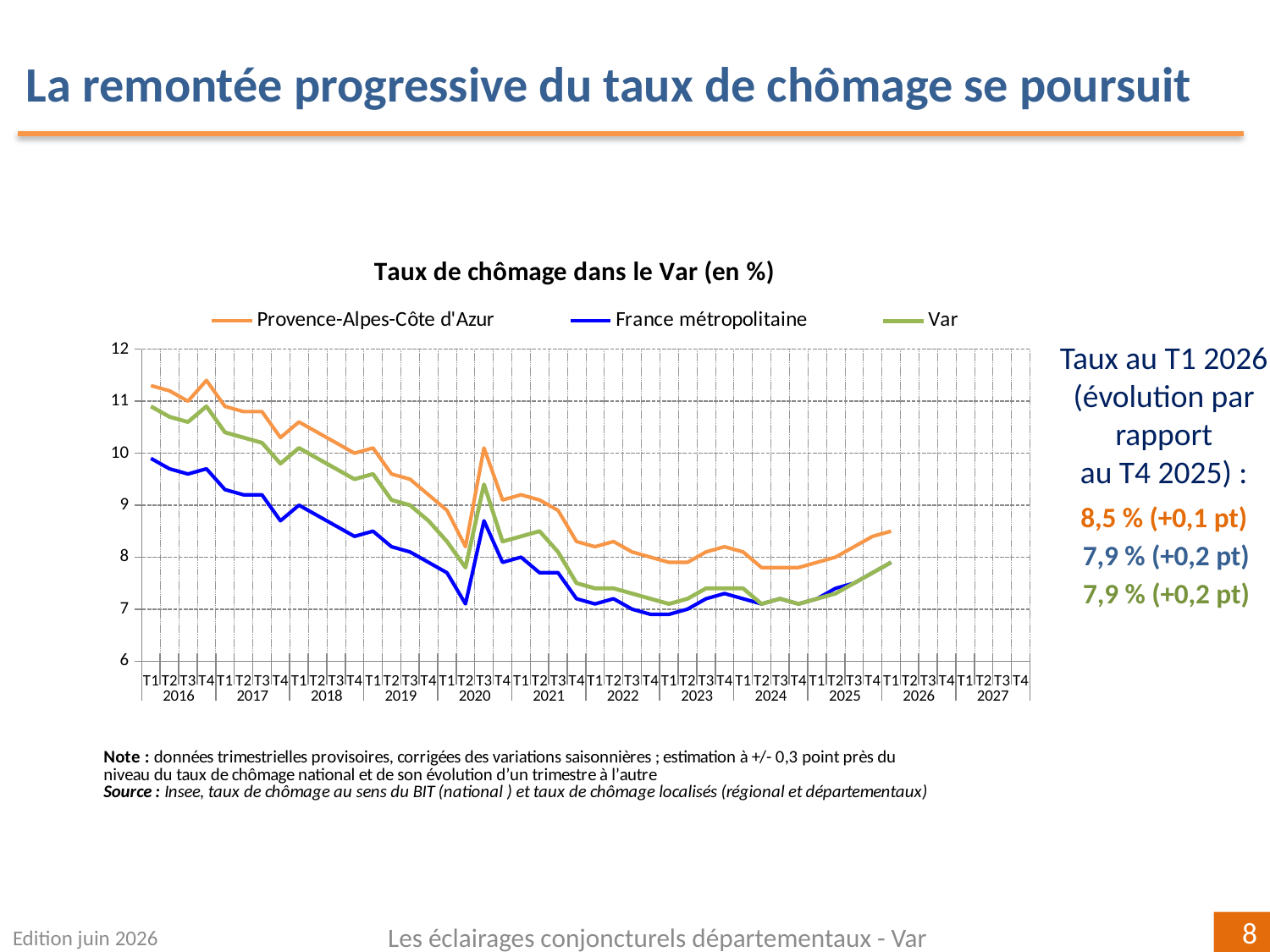
How many series does the legend list? 3 Overall, does the Var series rise or fall between 2016 and 2022? fall By how much did the Var unemployment rate change between T4 2025 and T1 2026? +0,2 pt At T1 2026, which is higher: the rate for Provence-Alpes-Côte d'Azur or the rate for Var? Provence-Alpes-Côte d'Azur What is the unemployment rate for France métropolitaine at T1 2026? 7,9 % Is the value for Provence-Alpes-Côte d'Azur at T1 2016 greater or less than 11? greater Which series has the highest value at T1 2026? Provence-Alpes-Côte d'Azur What kind of chart is shown on the slide? line chart What is the unemployment rate for Provence-Alpes-Côte d'Azur at T1 2026? 8,5 % What is the title of the chart? Taux de chômage dans le Var (en %) What is the unemployment rate for Var at T1 2026? 7,9 % What is the difference between the Provence-Alpes-Côte d'Azur rate and the Var rate at T1 2026? 0,6 pt